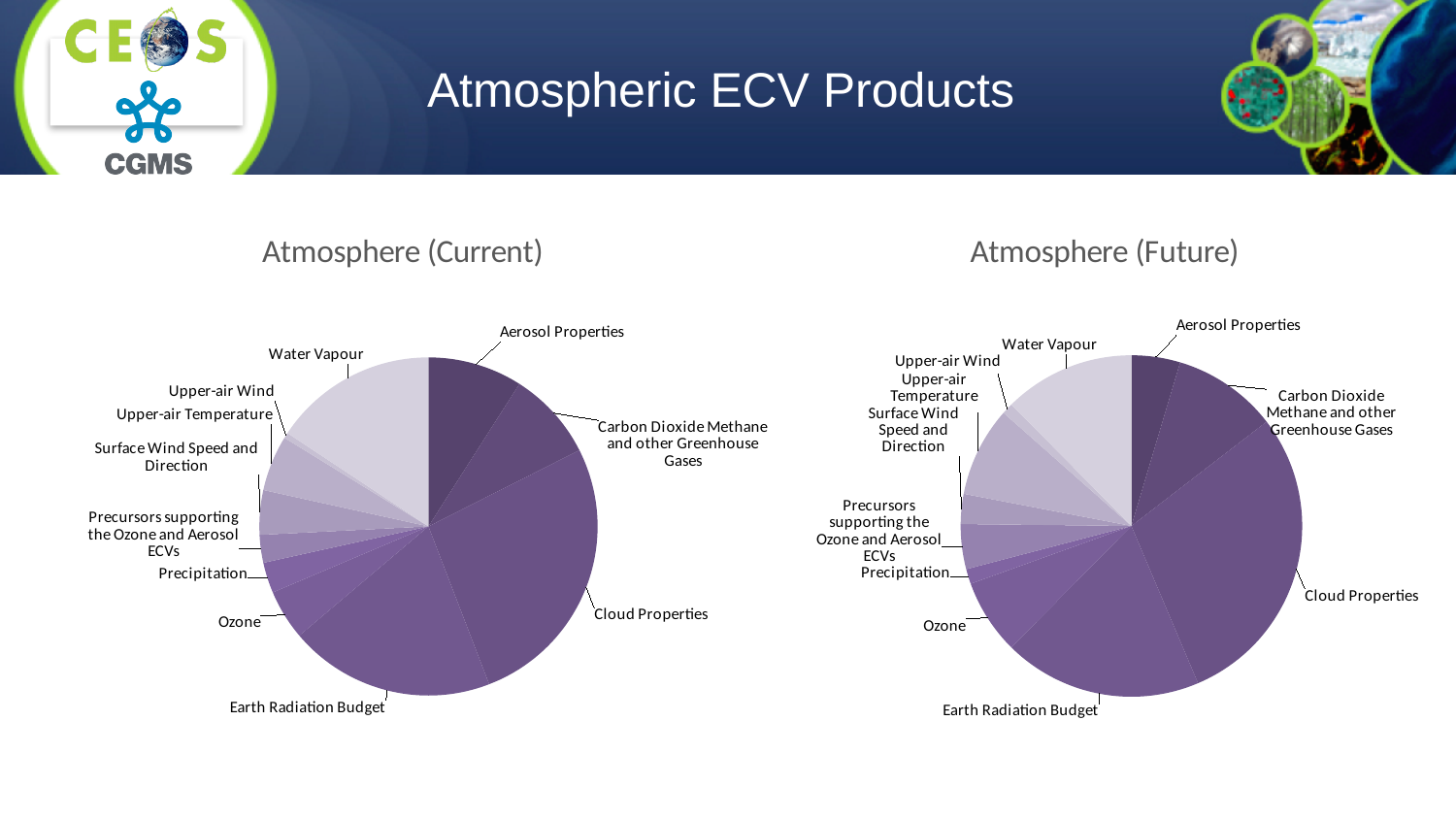
In the Atmosphere (Future) chart, which slice is larger: Water Vapour or Precipitation? Water Vapour How many slices does the Atmosphere (Current) pie chart have? 11 In the Atmosphere (Current) chart, which slice is larger: Earth Radiation Budget or Precipitation? Earth Radiation Budget What is the title of the pie chart on the left of the slide? Atmosphere (Current) What kind of chart is the Atmosphere (Current) chart? Pie chart What kind of chart is the Atmosphere (Future) chart? Pie chart In the Atmosphere (Current) chart, which slice is larger: Cloud Properties or Water Vapour? Cloud Properties How many slices does the Atmosphere (Future) pie chart have? 11 In the Atmosphere (Future) chart, which category has the largest slice? Cloud Properties In the Atmosphere (Current) chart, which category has the largest slice? Cloud Properties What is the title of the pie chart on the right of the slide? Atmosphere (Future)